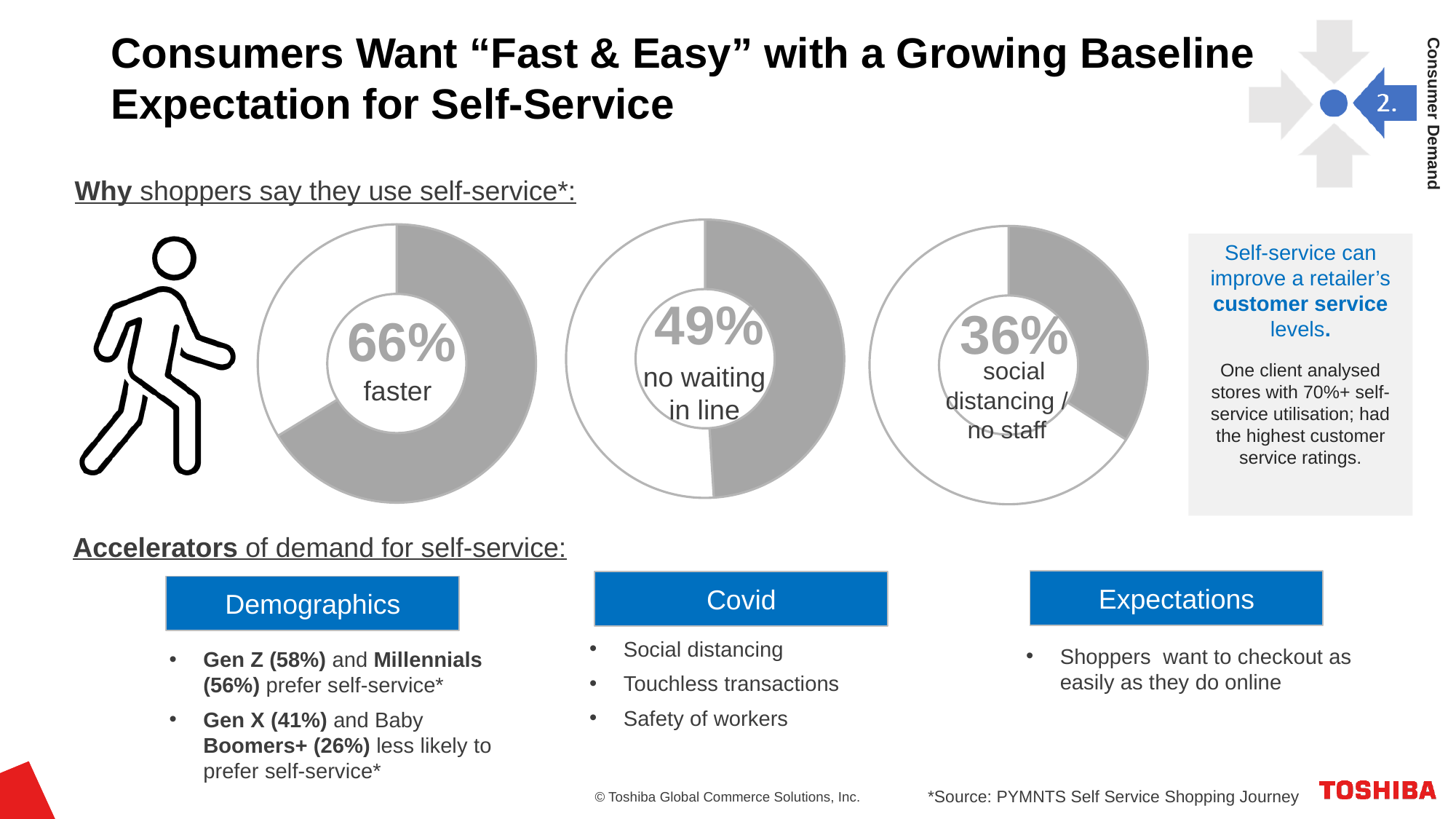
Which is larger: the percentage for 'faster' or the percentage for 'social distancing / no staff'? faster What percentage of shoppers say they use self-service because of social distancing / no staff? 36% Which reason for using self-service has the lowest percentage across the three donut charts? social distancing / no staff Which reason for using self-service has the highest percentage across the three donut charts? faster What is the difference between the percentage for 'no waiting in line' and the percentage for 'social distancing / no staff'? 13% How many donut charts are shown under 'Why shoppers say they use self-service'? 3 What percentage of shoppers say they use self-service because it is faster? 66% What is the difference between the percentage for 'faster' and the percentage for 'no waiting in line'? 17% What kind of chart is used to show the reasons shoppers use self-service? donut chart Is the percentage for 'no waiting in line' greater or less than 50%? less What colour is the filled portion of each donut chart? grey What percentage of shoppers say they use self-service because of no waiting in line? 49%